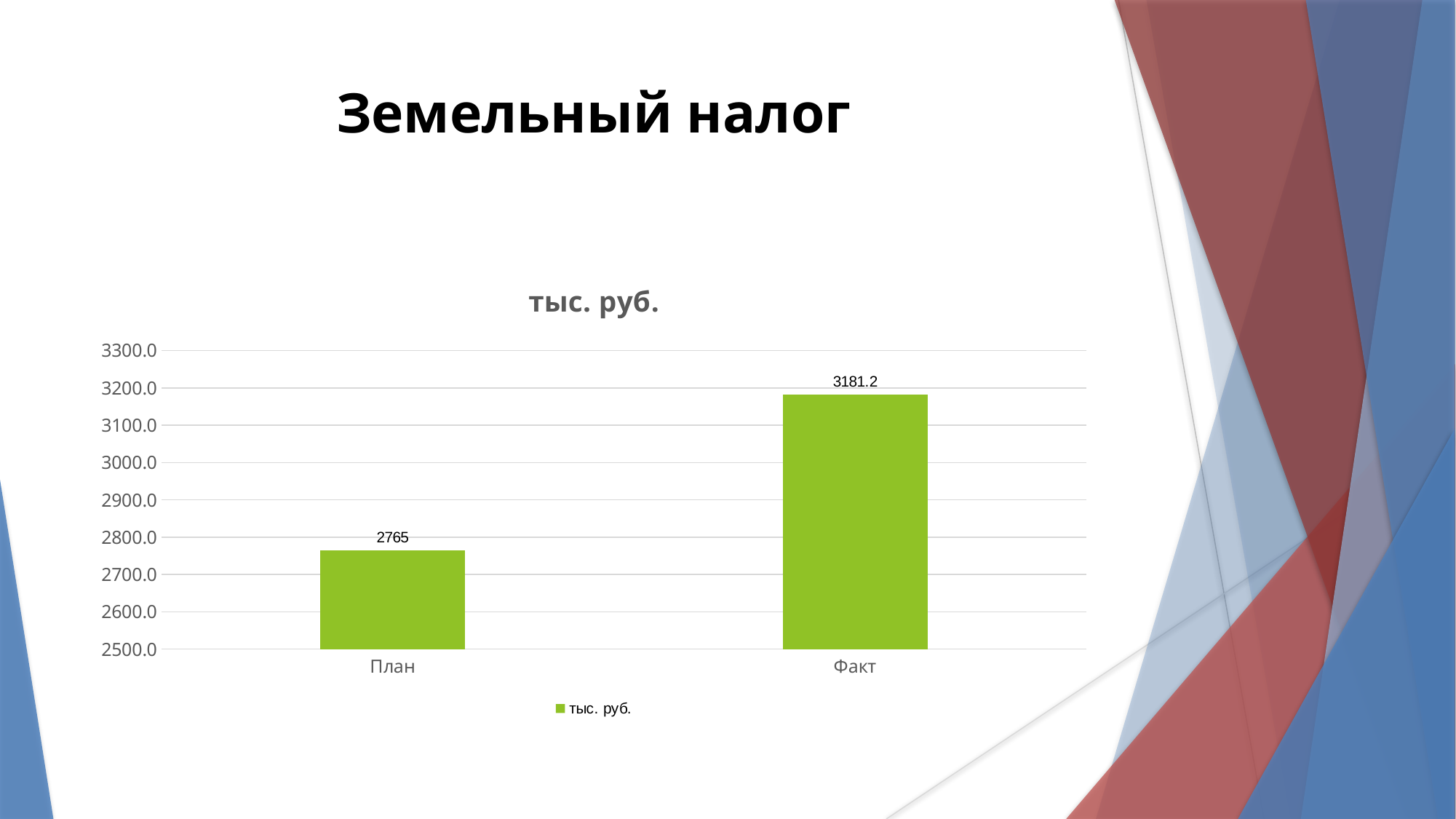
Is the value for План greater or less than 2800? less What is the value for План? 2765 How many series does the legend list? 1 What is the value for Факт? 3181.2 Which is larger, the value for План or the value for Факт? Факт What is the difference between the values for Факт and План? 416.2 Is the value for Факт greater or less than 3100? greater What is the title of the chart? тыс. руб. How many categories are shown on the x axis? 2 What kind of chart is shown? bar chart Which category has the highest value? Факт Which category has the lowest value? План